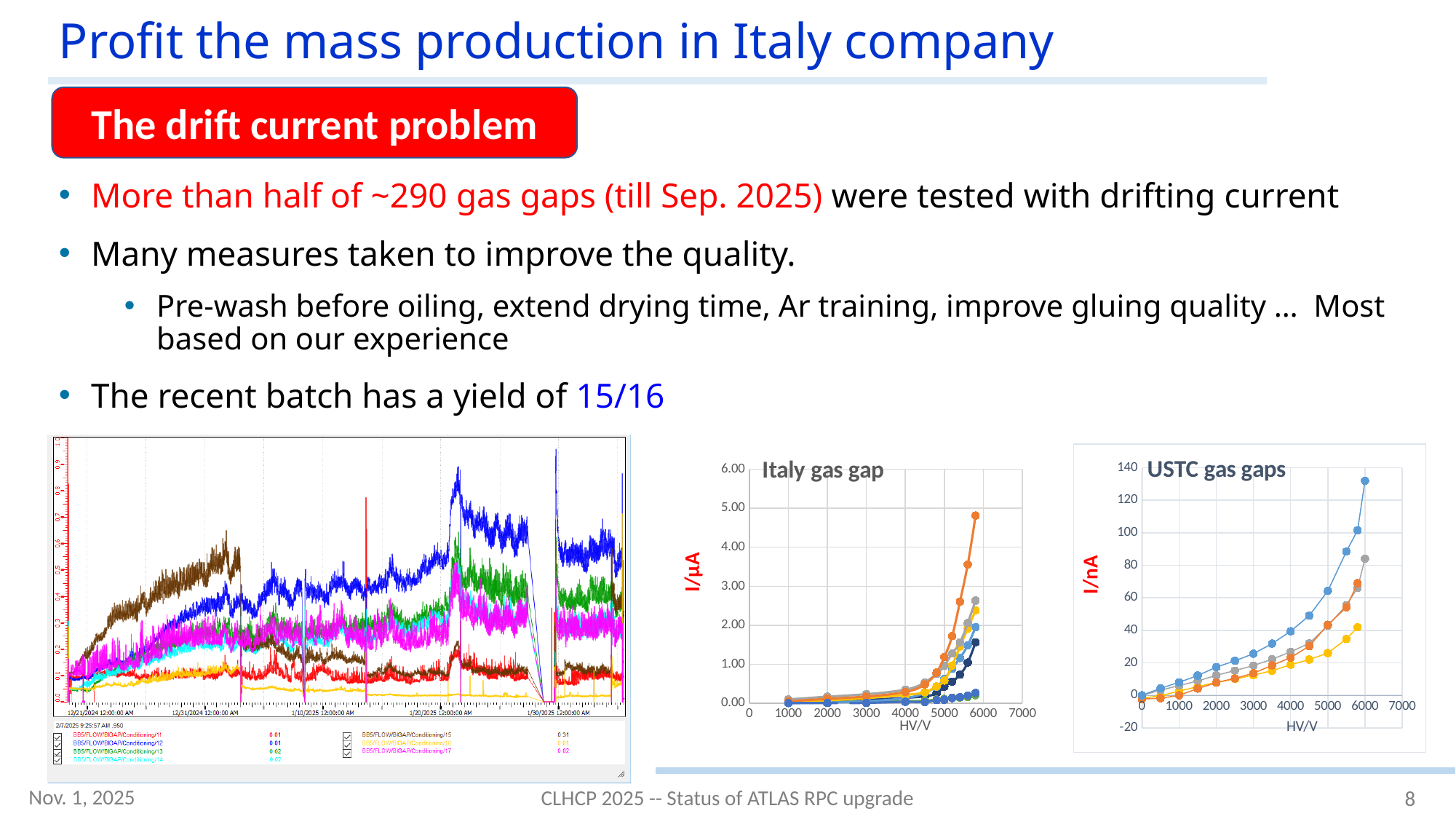
In the 'Italy gas gap' chart, is the highest value of the orange series greater or less than 4.00 μA? greater In the 'Italy gas gap' chart, which coloured series reaches the highest current at the highest voltage? orange In the 'USTC gas gaps' chart, is the highest value of the blue series greater or less than 120 nA? greater What is the x-axis label of the 'USTC gas gaps' chart? HV/V What kind of chart is the 'Italy gas gap' chart? line chart What is the y-axis label of the 'Italy gas gap' chart? I/μA In the 'USTC gas gaps' chart, which coloured series has the lowest current at 6000 V? gray In the 'USTC gas gaps' chart, do the current values rise or fall as HV increases? rise In the 'USTC gas gaps' chart, which coloured series reaches the highest current at 6000 V? blue In the 'Italy gas gap' chart, do the current values rise or fall as HV increases along the x axis? rise